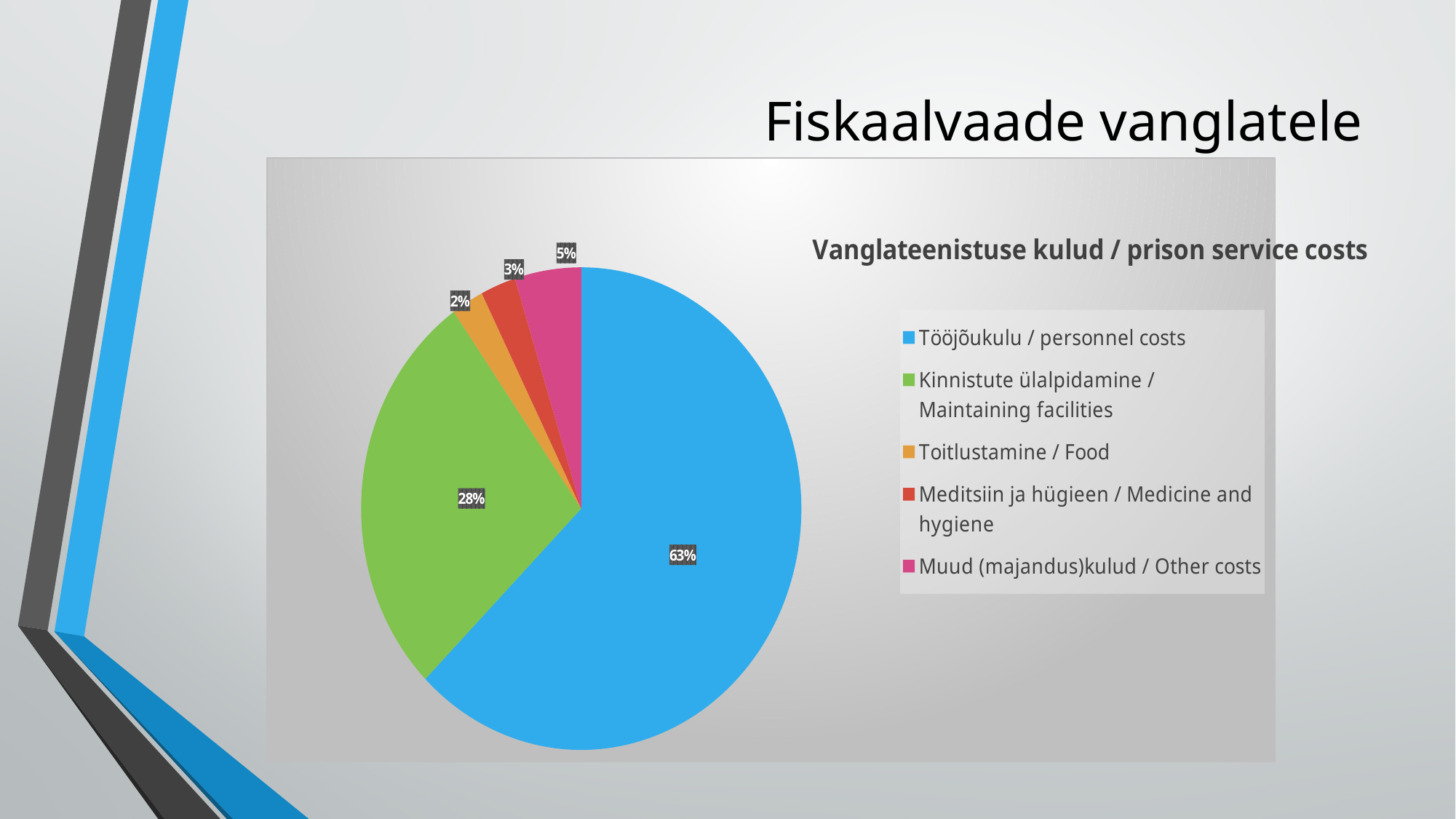
What share of prison service costs is Tööjõukulu / personnel costs? 63% How many categories does the legend list? 5 What share of prison service costs is Kinnistute ülalpidamine / Maintaining facilities? 28% What share of prison service costs is Meditsiin ja hügieen / Medicine and hygiene? 3% What share of prison service costs is Toitlustamine / Food? 2% What type of chart is shown on the slide? pie chart What is the difference in percentage points between personnel costs and maintaining facilities? 35 Which is larger: the share for Other costs or the share for Medicine and hygiene? Other costs What is the title of the chart? Vanglateenistuse kulud / prison service costs Which category has the largest share of prison service costs? Tööjõukulu / personnel costs Which category has the smallest share of prison service costs? Toitlustamine / Food What share of prison service costs is Muud (majandus)kulud / Other costs? 5%